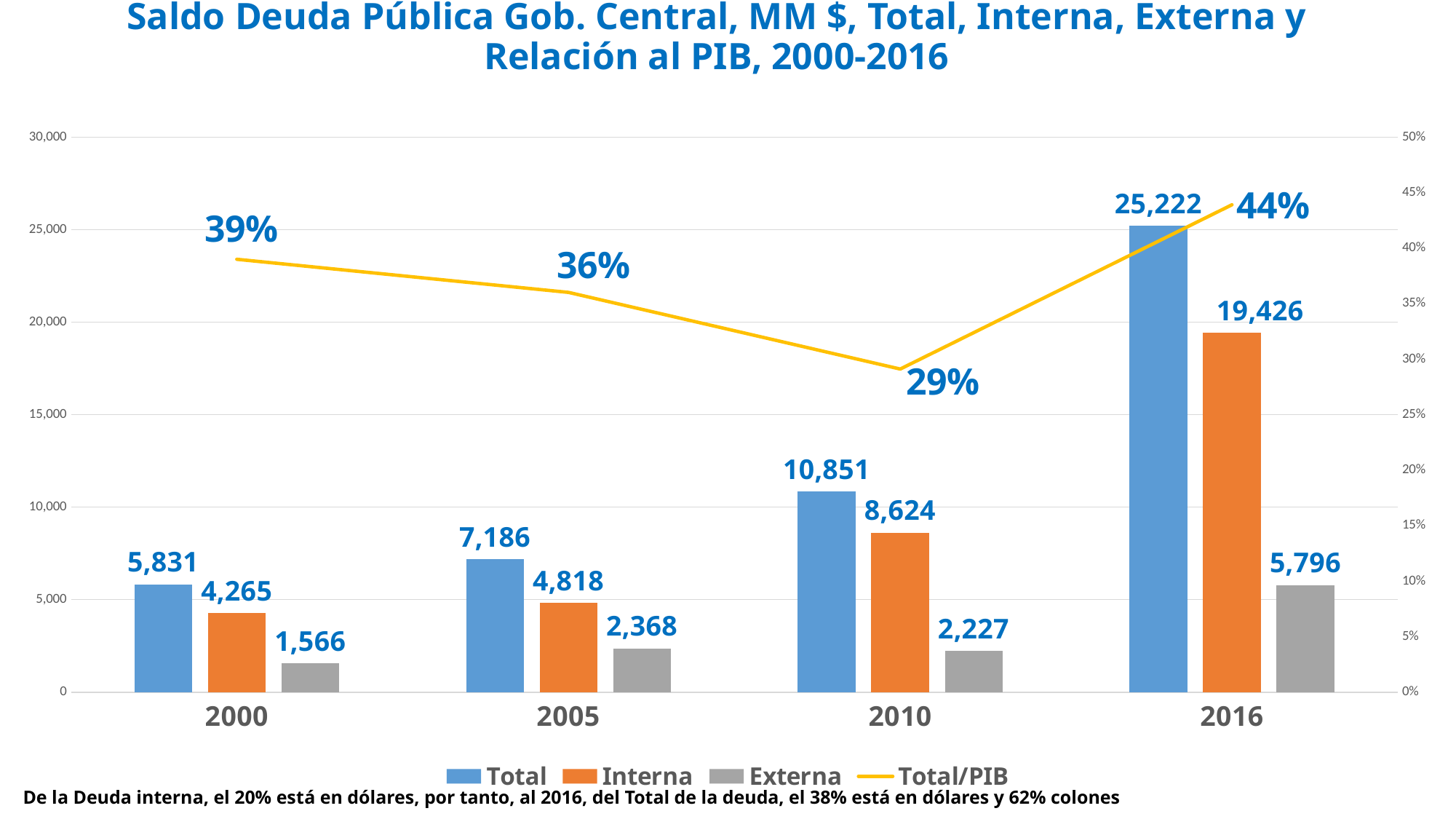
How many years are shown on the x axis? 4 How many series does the legend list? 4 What kind of chart is this? Combined bar and line chart Which is larger, the Externa value for 2005 or the Externa value for 2010? 2005 What is the difference between the Total and Interna values in 2000? 1,566 What is the Total/PIB ratio for 2010? 29% What is the Total debt value for 2016? 25,222 In which year is the Total/PIB ratio lowest? 2010 What is the Externa value for 2010? 2,227 What is the Interna value for 2005? 4,818 Does the Total debt rise or fall from 2000 to 2016? Rise In which year is the Total debt highest? 2016